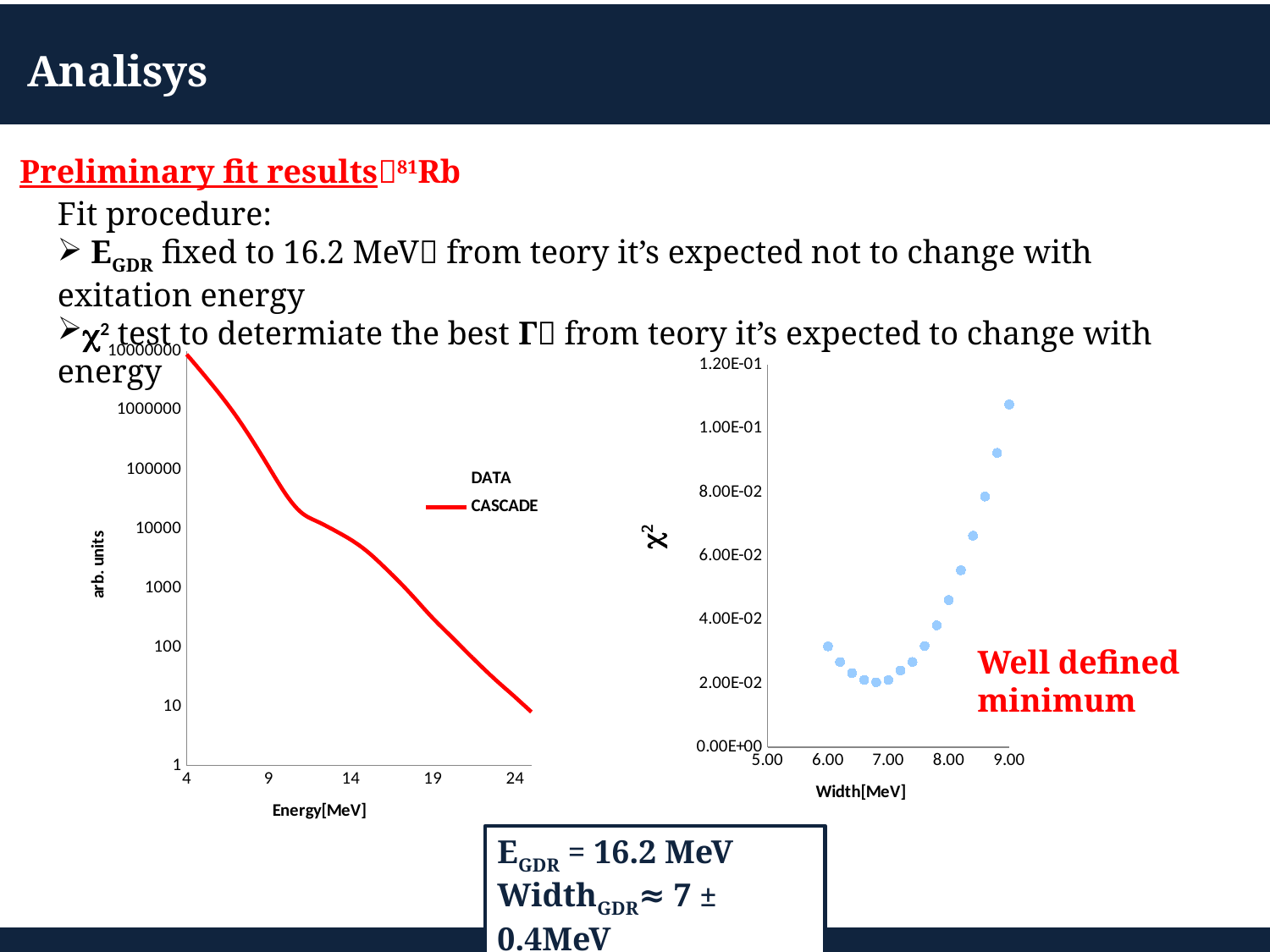
In the right chart, is the χ² value at a width of 6.00 greater or less than 4.00E-02? less In the right chart, at which width on the x axis is the χ² value highest? 9.00 In the right chart, is the χ² value at a width of 9.00 greater or less than 1.00E-01? greater In the left chart, do the values rise or fall as energy increases? fall What kind of chart is the right chart (χ² vs Width[MeV])? scatter chart What is the x-axis label of the left chart? Energy[MeV] What are the two series named in the legend of the left chart? DATA and CASCADE In the left chart, is the CASCADE value at 19 MeV greater or less than 1000? less In the right chart, which is larger: the χ² value at a width of 8.00 or at a width of 7.00? 8.00 How many series does the legend of the left chart list? 2 What kind of chart is the left chart (arb. units vs Energy[MeV])? line chart